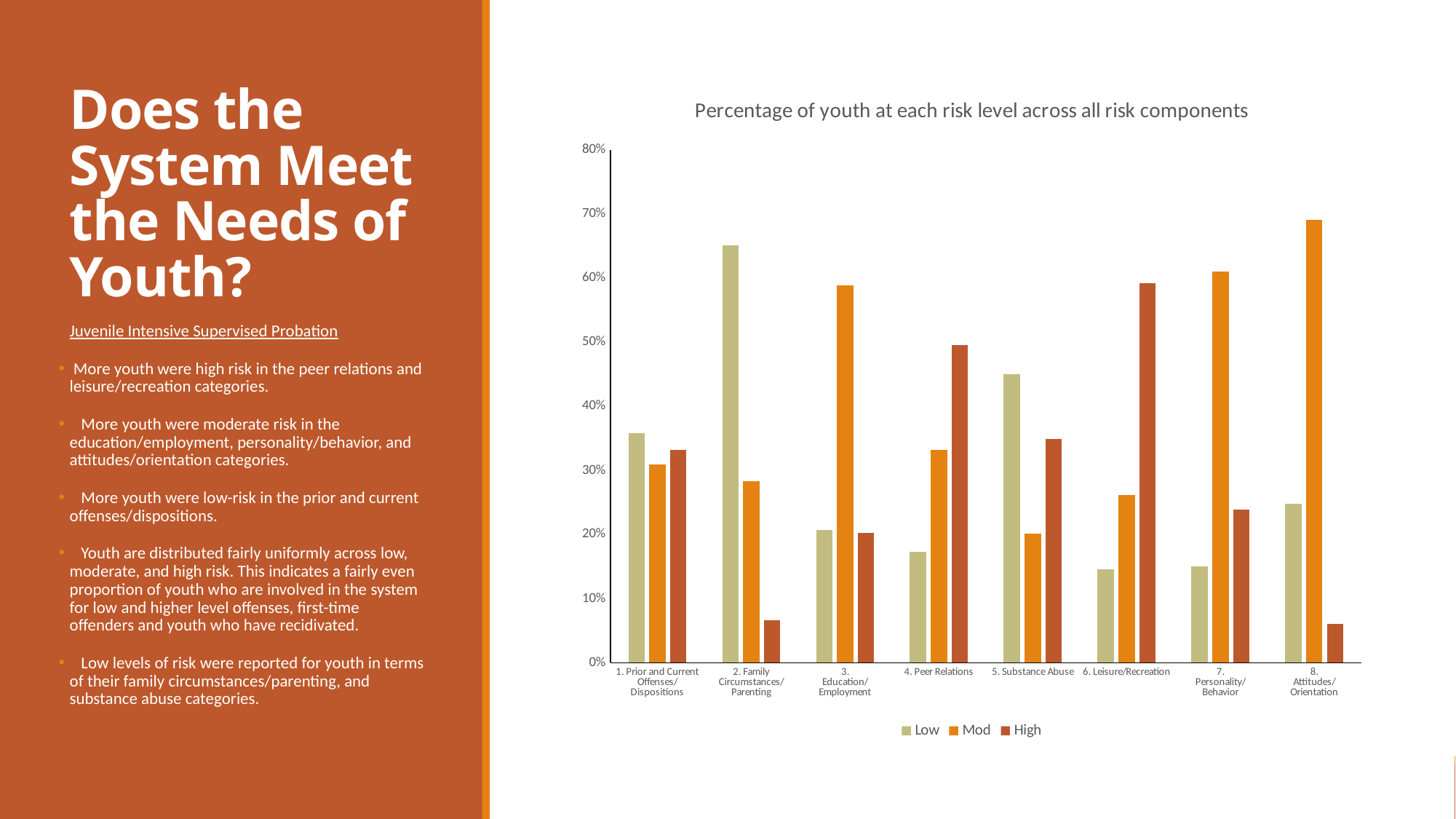
How many series does the chart's legend list? 3 Is the Low value for 4. Peer Relations greater or less than 20%? less For 4. Peer Relations, which is larger: the High bar or the Mod bar? High What kind of chart is shown on the slide? Bar chart Which category has the highest Mod bar? 8. Attitudes/Orientation What is the title of the chart? Percentage of youth at each risk level across all risk components Is the Mod value for 8. Attitudes/Orientation greater or less than 60%? greater Is the Low value for 2. Family Circumstances/Parenting greater or less than 60%? greater For 5. Substance Abuse, which is larger: the Low bar or the High bar? Low Which category has the highest High bar? 6. Leisure/Recreation How many risk component categories are shown on the x axis? 8 Which category has the highest Low bar? 2. Family Circumstances/Parenting